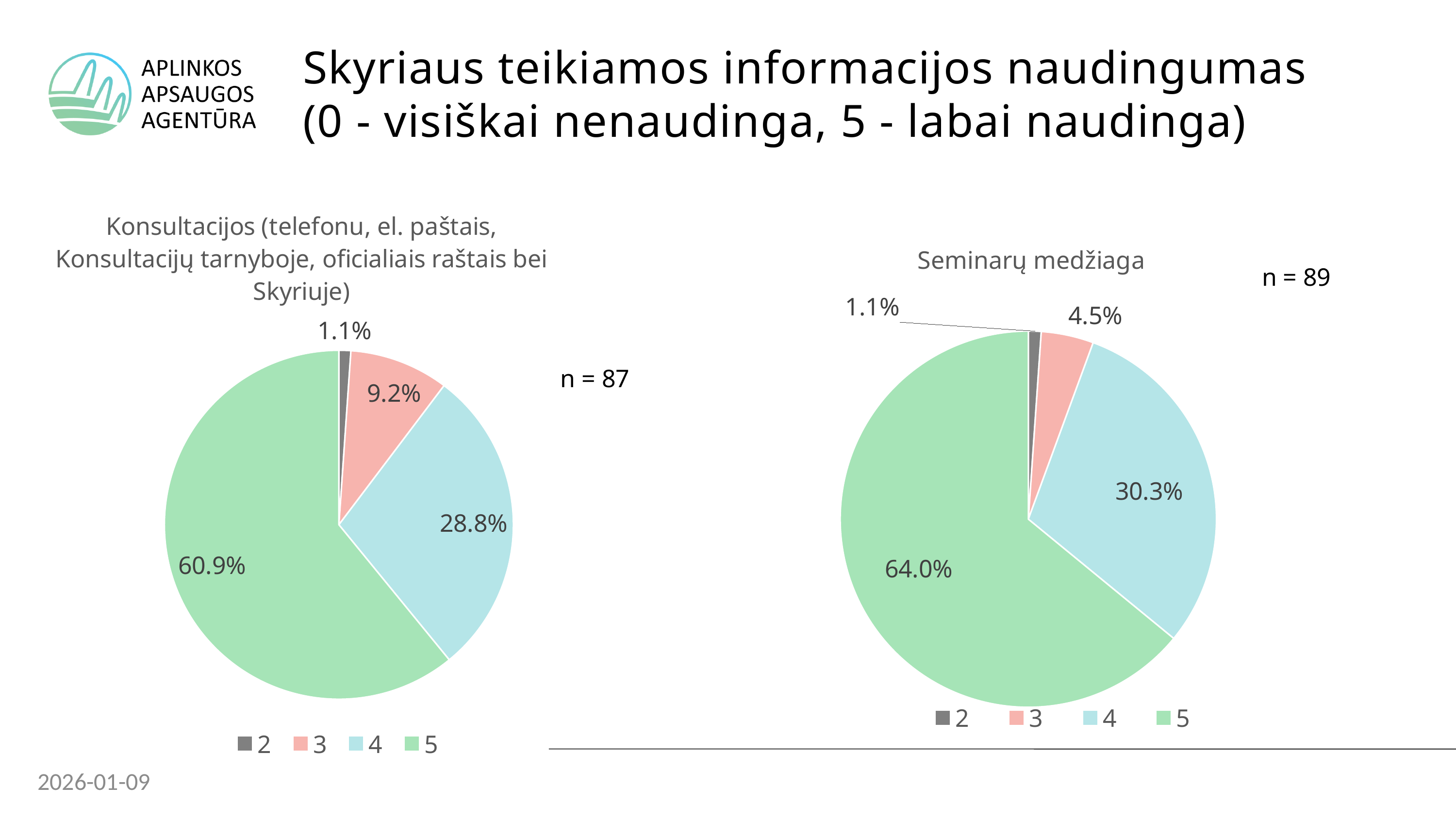
In the 'Konsultacijos' pie chart on the left, what is the difference in percentage points between the shares for rating 5 and rating 4? 32.1 What is the sample size (n) shown next to the 'Konsultacijos' pie chart on the left? n = 87 In the 'Konsultacijos' pie chart on the left, what share is shown for rating 4? 28.8% What type of chart is used for 'Seminarų medžiaga'? Pie chart In the 'Seminarų medžiaga' pie chart, what is the difference in percentage points between the shares for rating 4 and rating 3? 25.8 Which chart shows a larger share for rating 5: the 'Konsultacijos' chart or the 'Seminarų medžiaga' chart? Seminarų medžiaga In the 'Konsultacijos' pie chart on the left, which rating has the smallest slice? 2 In the 'Seminarų medžiaga' pie chart, what share is shown for rating 3? 4.5% How many slices does the 'Seminarų medžiaga' pie chart have? 4 In the 'Konsultacijos' pie chart on the left, what share is shown for rating 3? 9.2% In the 'Seminarų medžiaga' pie chart, which rating has the largest slice? 5 In the 'Seminarų medžiaga' pie chart, what share is shown for rating 5? 64.0%